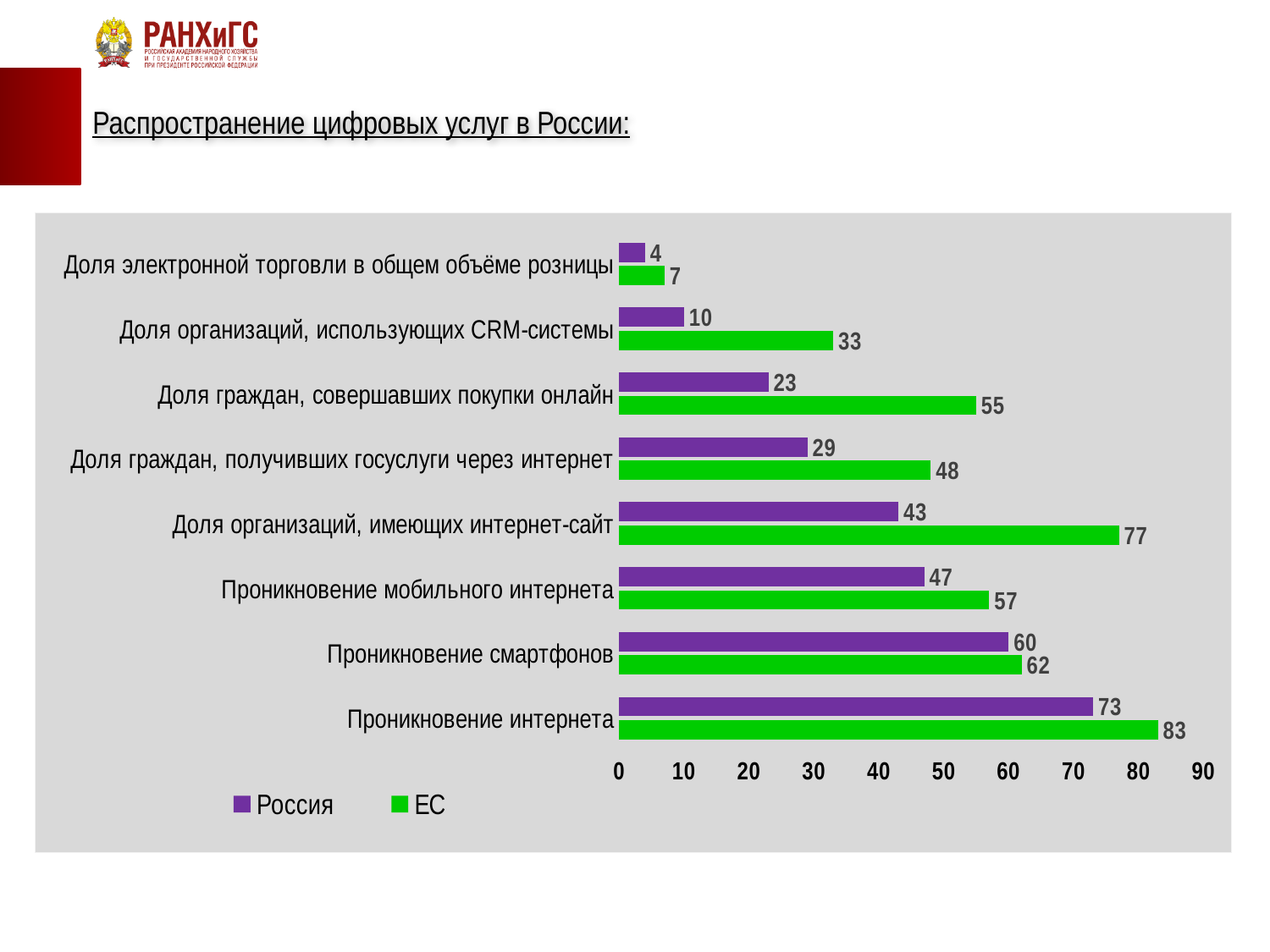
How many series does the legend list? 2 Which colour represents the ЕС series in the chart? Green What is the value for Россия for Доля граждан, получивших госуслуги через интернет? 29 What is the value for ЕС for Доля организаций, использующих CRM-системы? 33 What kind of chart is shown on the slide? Bar chart What is the difference between the ЕС and Россия values for Проникновение смартфонов? 2 What is the value for Россия for Проникновение интернета? 73 What is the difference between the ЕС and Россия values for Доля организаций, имеющих интернет-сайт? 34 Which is larger for Доля граждан, совершавших покупки онлайн: the value for Россия or for ЕС? ЕС Which category has the lowest value for Россия? Доля электронной торговли в общем объёме розницы How many categories are shown on the chart? 8 Which category has the highest value for ЕС? Проникновение интернета